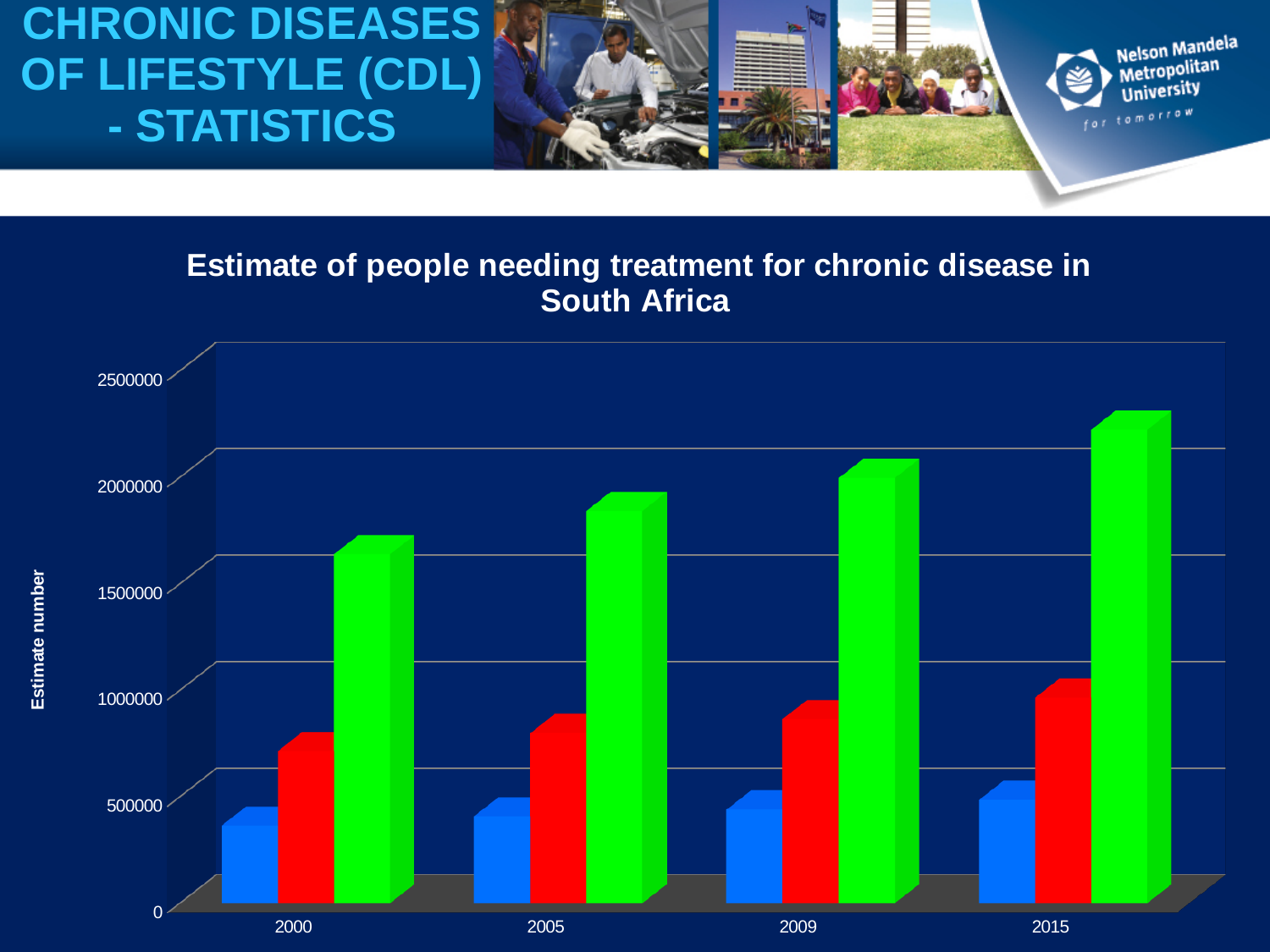
How many years are shown on the x axis of the chart? 4 Which is larger in 2005, the red bar or the blue bar? red bar How many bars are plotted for each year in the chart? 3 Which year has the shortest green bar? 2000 Which year has the tallest green bar? 2015 Is the green bar for 2015 greater or less than 2000000? greater Is the blue bar for 2000 greater or less than 500000? less Do the green bars rise or fall from 2000 to 2015? rise Is the red bar for 2000 greater or less than 1000000? less What kind of chart is shown on the slide? bar chart What is the title of the chart? Estimate of people needing treatment for chronic disease in South Africa